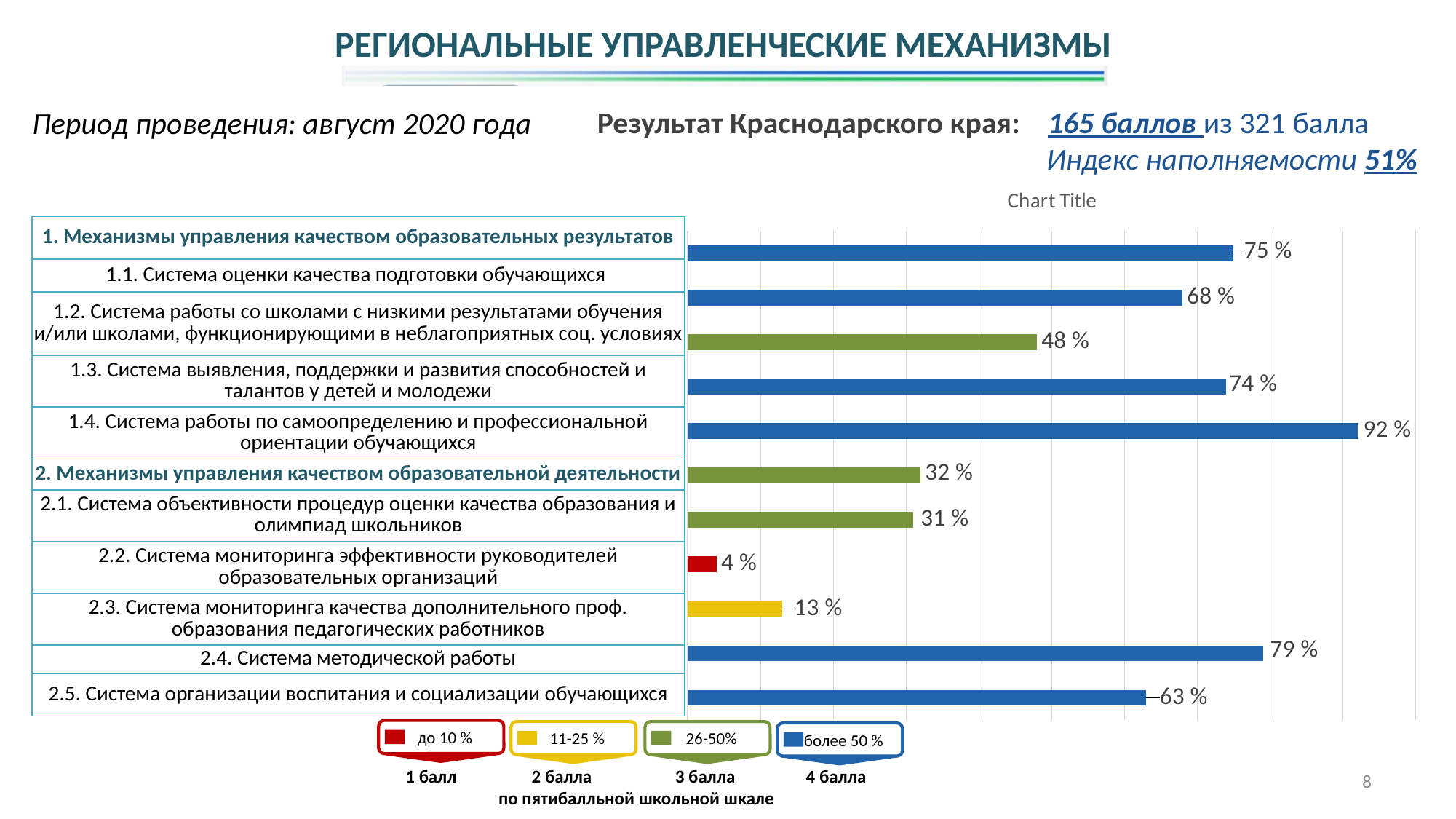
Which is larger: the value for 1.1. Система оценки качества подготовки обучающихся or the value for 1.3. Система выявления, поддержки и развития способностей и талантов у детей и молодежи? 1.3. Система выявления, поддержки и развития способностей и талантов у детей и молодежи What value is shown for 2.2. Система мониторинга эффективности руководителей образовательных организаций? 4 % Which category has the lowest value in the chart? 2.2. Система мониторинга эффективности руководителей образовательных организаций What value is shown for 1.4. Система работы по самоопределению и профессиональной ориентации обучающихся? 92 % What value is shown for 2.4. Система методической работы? 79 % Which category has the highest value in the chart? 1.4. Система работы по самоопределению и профессиональной ориентации обучающихся What kind of chart is shown on the slide? Bar chart What is the difference between the values for 2.4. Система методической работы and 2.5. Система организации воспитания и социализации обучающихся? 16 % According to the colour legend below the chart, which range does the blue colour represent? более 50 % What value is shown for 1.2. Система работы со школами с низкими результатами обучения? 48 % How many bars are plotted in the chart? 11 What colour is the bar for 2.3. Система мониторинга качества дополнительного проф. образования педагогических работников? Yellow